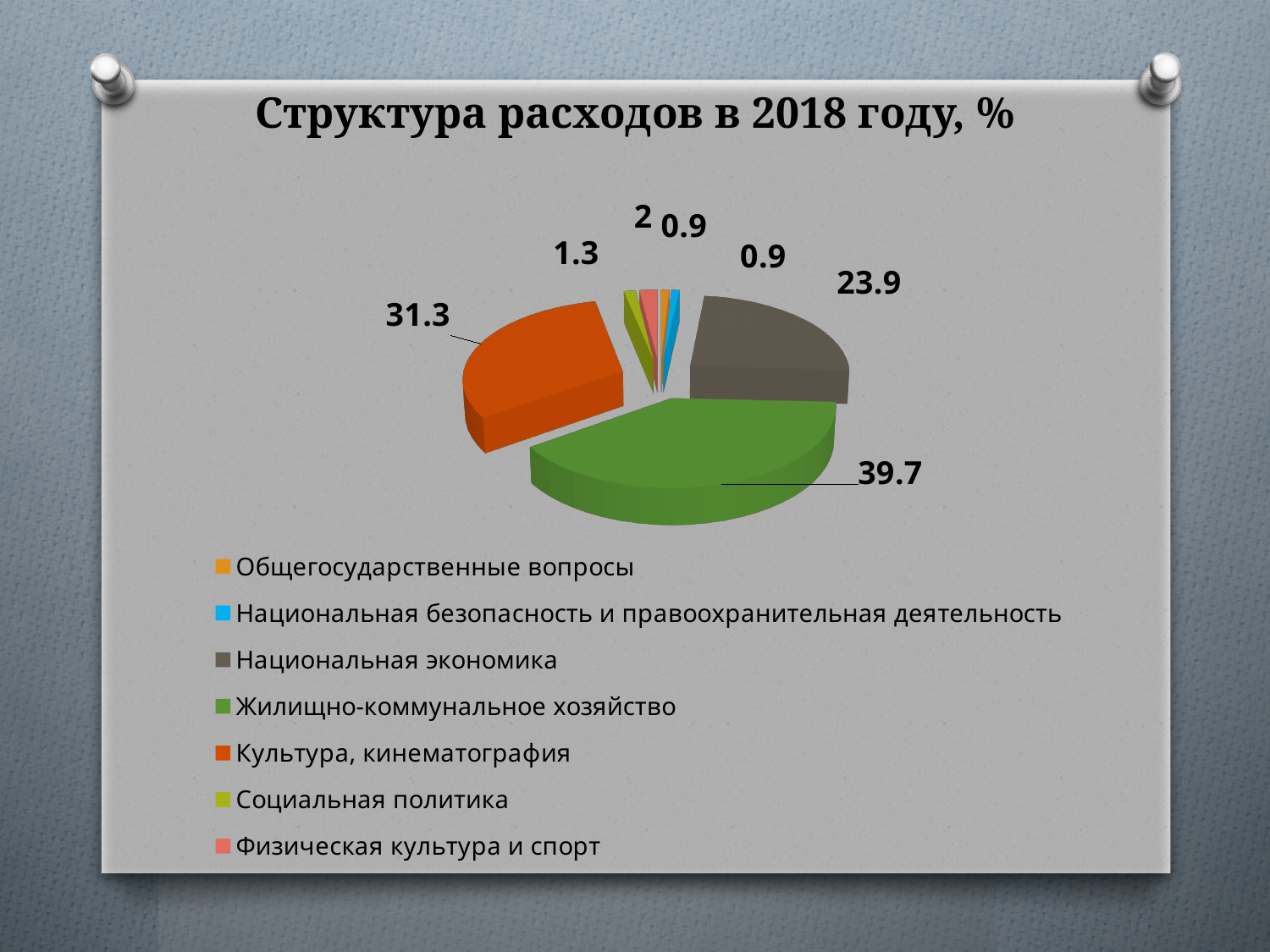
How many categories does the legend list? 7 What is the value for Жилищно-коммунальное хозяйство? 39.7 What is the value for Национальная экономика? 23.9 What is the difference between the values for Жилищно-коммунальное хозяйство and Культура, кинематография? 8.4 What kind of chart is shown on the slide? Pie chart What colour is the slice for Жилищно-коммунальное хозяйство? Green Which category has the largest share of expenditures? Жилищно-коммунальное хозяйство What is the value for Культура, кинематография? 31.3 What is the combined value of the three largest slices (Жилищно-коммунальное хозяйство, Культура, кинематография and Национальная экономика)? 94.9 Which is larger: the value for Национальная экономика or the value for Культура, кинематография? Культура, кинематография What is the difference between the values for Культура, кинематография and Национальная экономика? 7.4 What is the title of the chart? Структура расходов в 2018 году, %